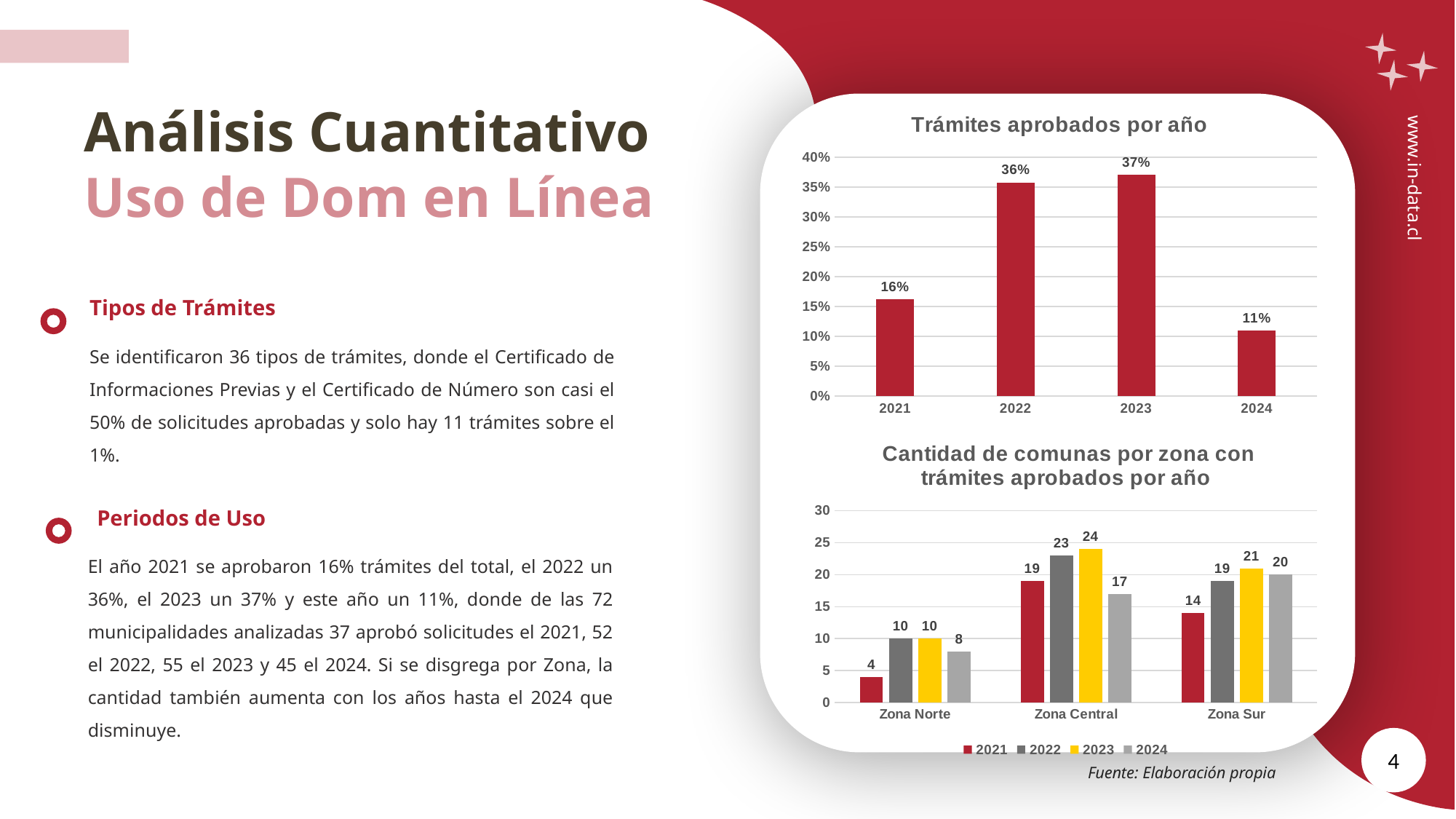
In the 'Cantidad de comunas por zona con trámites aprobados por año' chart, what is the difference between Zona Central in 2023 and Zona Central in 2024? 7 In the 'Trámites aprobados por año' chart, which year has the highest value? 2023 What kind of chart is 'Trámites aprobados por año'? Bar chart In the 'Cantidad de comunas por zona con trámites aprobados por año' chart, how many series does the legend list? 4 In the 'Trámites aprobados por año' chart, which year has the lowest value? 2024 In the 'Cantidad de comunas por zona con trámites aprobados por año' chart, what is the value for Zona Norte in 2021? 4 In the 'Trámites aprobados por año' chart, what is the difference between the values for 2022 and 2021? 20% In the 'Trámites aprobados por año' chart, what is the value for 2022? 36% In the 'Trámites aprobados por año' chart, how many years are shown on the x axis? 4 In the 'Cantidad de comunas por zona con trámites aprobados por año' chart, which colour represents the 2023 series? Yellow In the 'Cantidad de comunas por zona con trámites aprobados por año' chart, which is larger: Zona Sur in 2022 or Zona Sur in 2024? Zona Sur in 2024 In the 'Cantidad de comunas por zona con trámites aprobados por año' chart, what is the value for Zona Central in 2023? 24